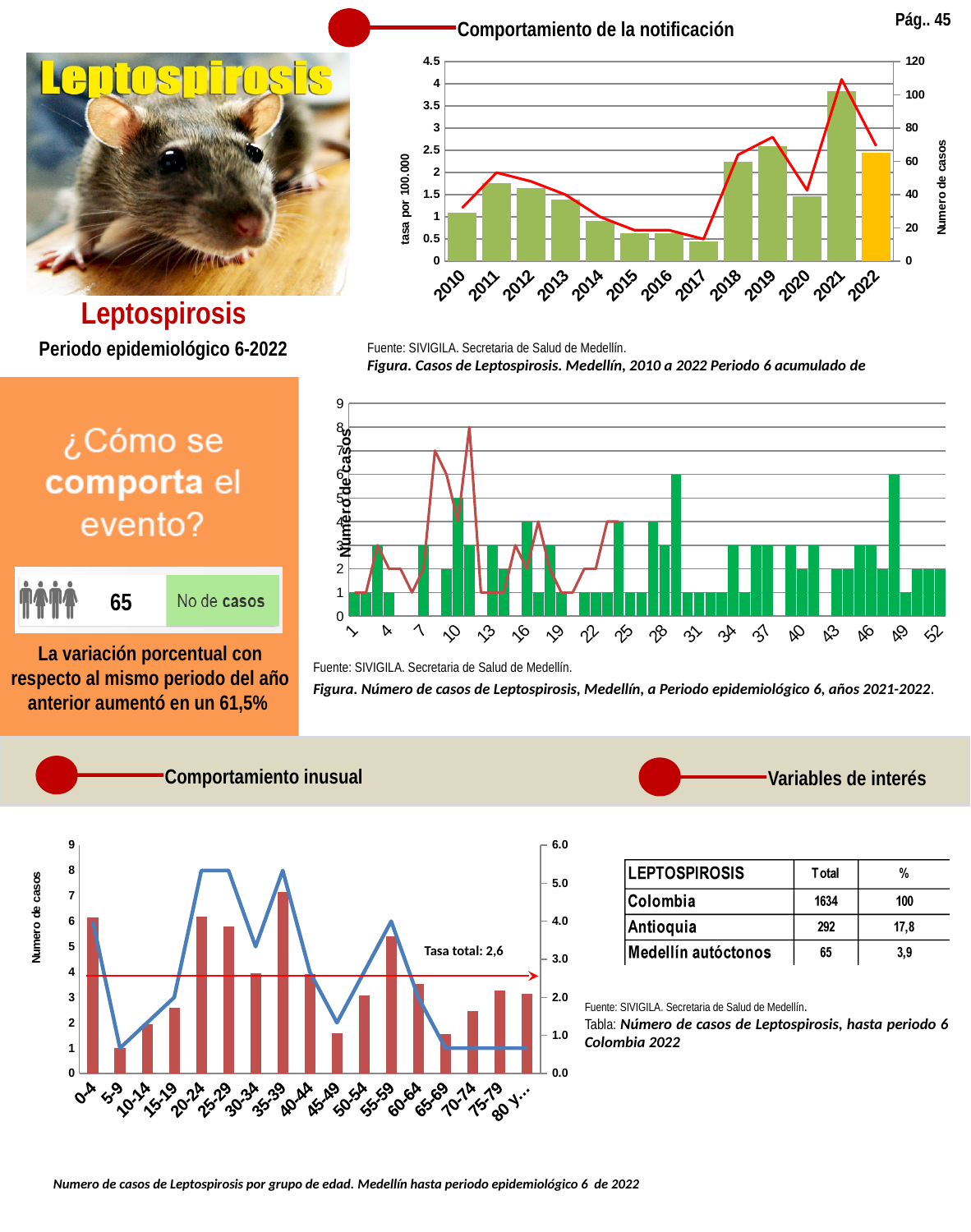
In the top-right chart (Casos de Leptospirosis, Medellín, 2010 a 2022), which year has the tallest bar? 2021 In the top-right chart (Casos de Leptospirosis, Medellín, 2010 a 2022), how many years are shown on the x axis? 13 In the top-right chart (Casos de Leptospirosis, Medellín, 2010 a 2022), is the number of cases for 2021 greater or less than 80? greater In the bottom-left chart (casos de Leptospirosis por grupo de edad), what is the 'Tasa total' value printed on the chart? 2,6 In the middle chart (Número de casos de Leptospirosis, Medellín, años 2021-2022), is the highest point of the red line greater or less than 7? greater In the bottom-left chart (casos de Leptospirosis por grupo de edad), which age group has the shortest bar? 5-9 In the bottom-left chart (casos de Leptospirosis por grupo de edad), is the number of cases for the 35-39 age group greater or less than 6? greater In the top-right chart (Casos de Leptospirosis, Medellín, 2010 a 2022), which year has the shortest bar? 2017 In the top-right chart (Casos de Leptospirosis, Medellín, 2010 a 2022), which year's bar is coloured orange instead of green? 2022 In the bottom-left chart (casos de Leptospirosis por grupo de edad), which has more cases, the 20-24 age group or the 10-14 age group? 20-24 In the bottom-left chart (casos de Leptospirosis por grupo de edad), which age group has the tallest bar? 35-39